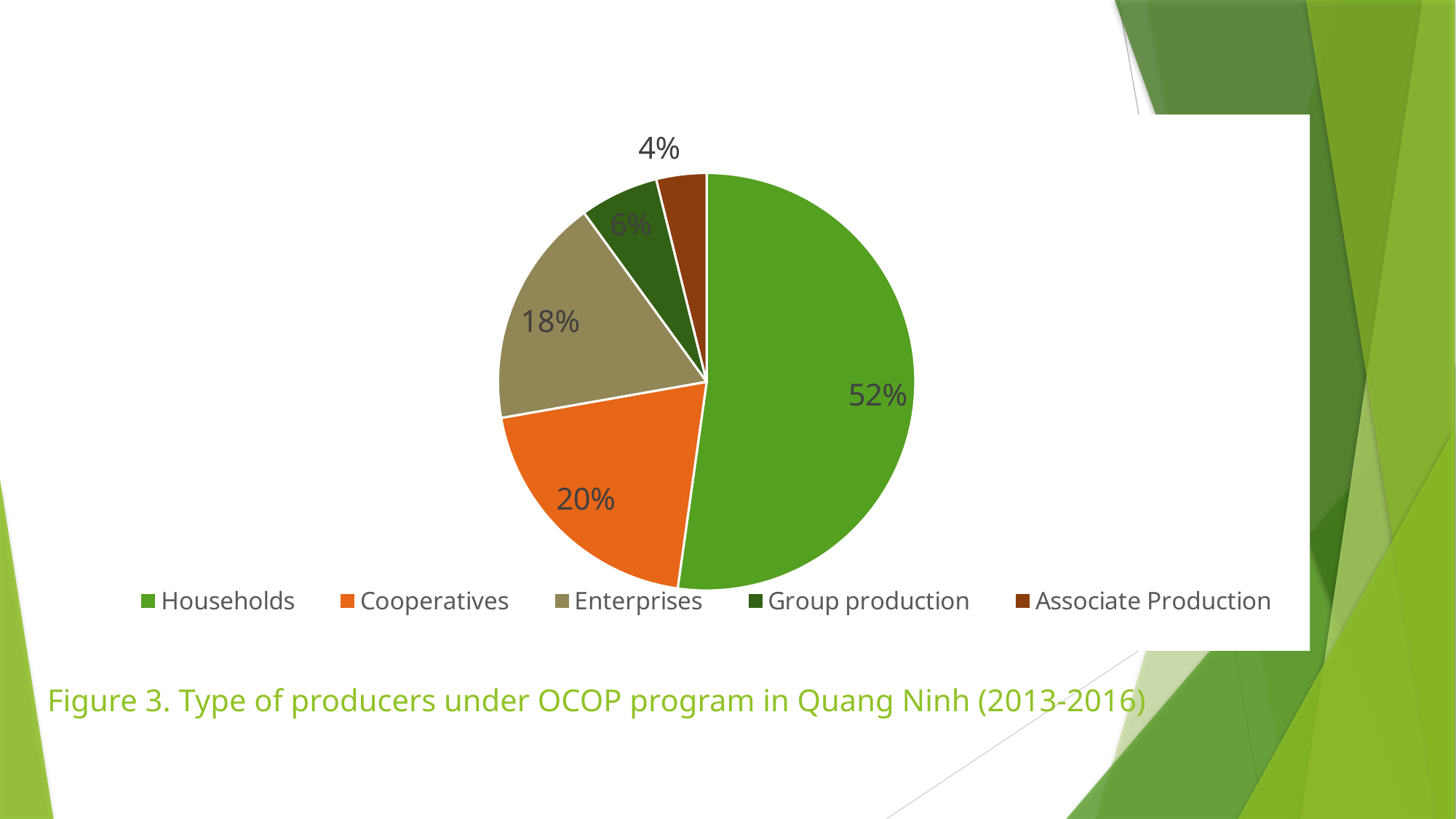
How many categories does the pie chart show? 5 What share of producers are Group production? 6% What share of producers are Households? 52% Which type of producer has the largest share of the pie? Households Which type of producer has the smallest share of the pie? Associate Production What share of producers are Associate Production? 4% What share of producers are Enterprises? 18% What is the difference in percentage points between the Households share and the Cooperatives share? 32 What is the caption of the figure on the slide? Figure 3. Type of producers under OCOP program in Quang Ninh (2013-2016) What kind of chart is shown on the slide? Pie chart Which has a larger share, Cooperatives or Enterprises? Cooperatives What share of producers are Cooperatives? 20%